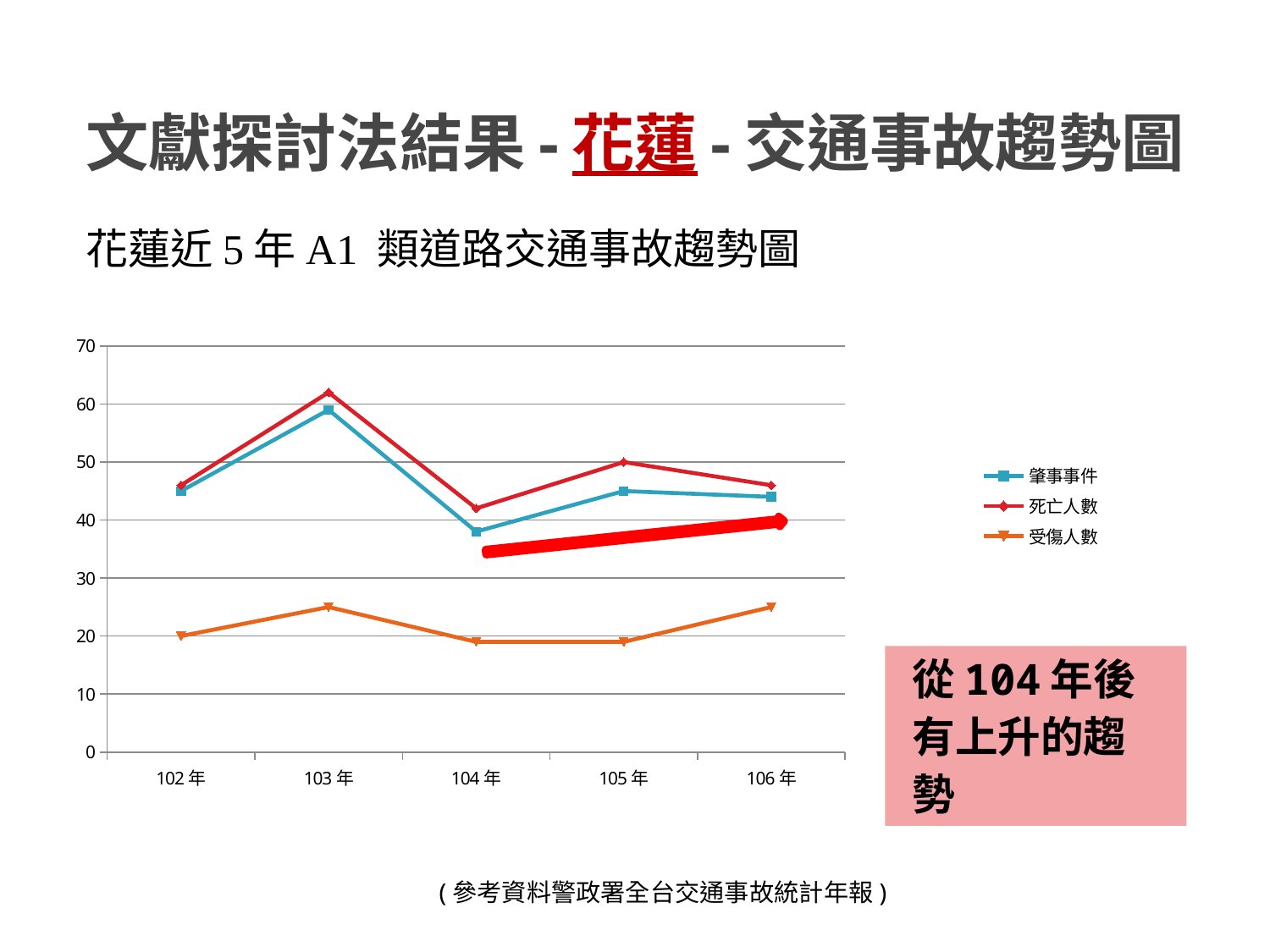
Is the value of 受傷人數 in 106年 greater or less than 20? greater How many years are plotted along the x axis? 5 Does 肇事事件 rise or fall from 103年 to 104年? fall Is the value of 肇事事件 in 103年 greater or less than 50? greater What kind of chart is shown on the slide? line chart How many series does the legend list? 3 In which year does 死亡人數 reach its highest value? 103年 Is the value of 受傷人數 in 103年 greater or less than 30? less In 103年, which is larger: 死亡人數 or 受傷人數? 死亡人數 Which series is shown in orange in the legend? 受傷人數 In which year is 肇事事件 at its lowest? 104年